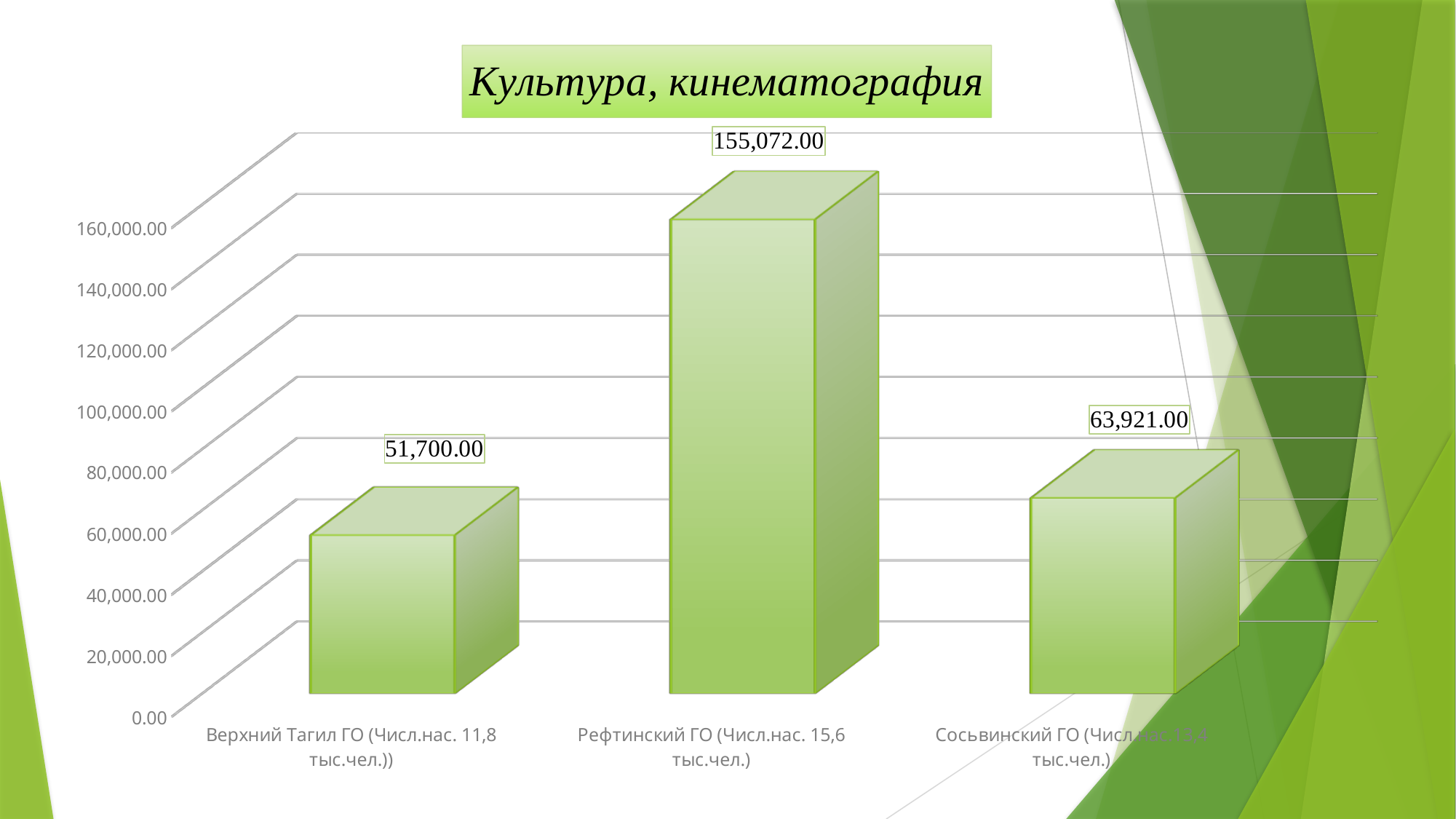
What is the value for Верхний Тагил ГО? 51,700.00 How many categories are shown in the chart? 3 What is the difference between the values for Рефтинский ГО and Сосьвинский ГО? 91,151.00 Is the value for Рефтинский ГО greater or less than 140,000.00? greater Which category has the lowest value? Верхний Тагил ГО What is the value for Сосьвинский ГО? 63,921.00 What is the difference between the values for Сосьвинский ГО and Верхний Тагил ГО? 12,221.00 What is the title of the chart? Культура, кинематография What is the value for Рефтинский ГО? 155,072.00 Which is larger, the value for Сосьвинский ГО or the value for Верхний Тагил ГО? Сосьвинский ГО Which category has the highest value? Рефтинский ГО What kind of chart is shown on the slide? bar chart